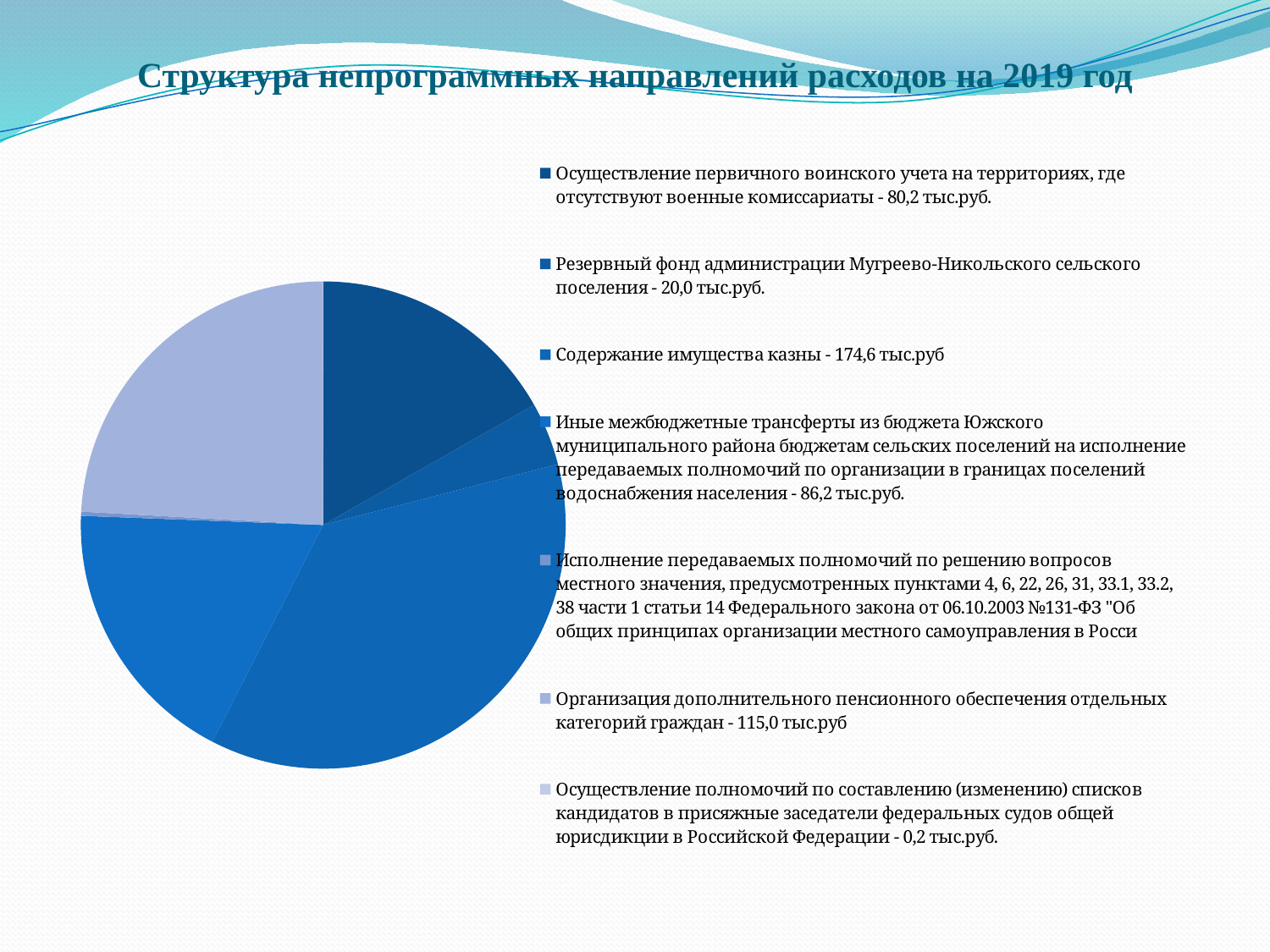
What is the title of the slide containing the pie chart? Структура непрограммных направлений расходов на 2019 год What is the difference between the value for "Осуществление первичного воинского учета" (80,2) and the value for "Резервный фонд администрации" (20,0)? 60,2 тыс.руб. What is the value for "Осуществление полномочий по составлению (изменению) списков кандидатов в присяжные заседатели федеральных судов общей юрисдикции в Российской Федерации"? 0,2 тыс.руб. How many entries does the legend of the pie chart list? 7 Which is larger: the value for "Содержание имущества казны" or the value for "Организация дополнительного пенсионного обеспечения отдельных категорий граждан"? Содержание имущества казны What is the value for "Организация дополнительного пенсионного обеспечения отдельных категорий граждан"? 115,0 тыс.руб What is the value for "Содержание имущества казны"? 174,6 тыс.руб What is the value for "Осуществление первичного воинского учета на территориях, где отсутствуют военные комиссариаты"? 80,2 тыс.руб. What is the value for "Резервный фонд администрации Мугреево-Никольского сельского поселения"? 20,0 тыс.руб. What is the value for the inter-budget transfers from the Южский municipal district budget for water supply ("Иные межбюджетные трансферты...")? 86,2 тыс.руб. What is the difference between the value for "Содержание имущества казны" (174,6) and the value for "Организация дополнительного пенсионного обеспечения отдельных категорий граждан" (115,0)? 59,6 тыс.руб What kind of chart is shown on the slide? pie chart